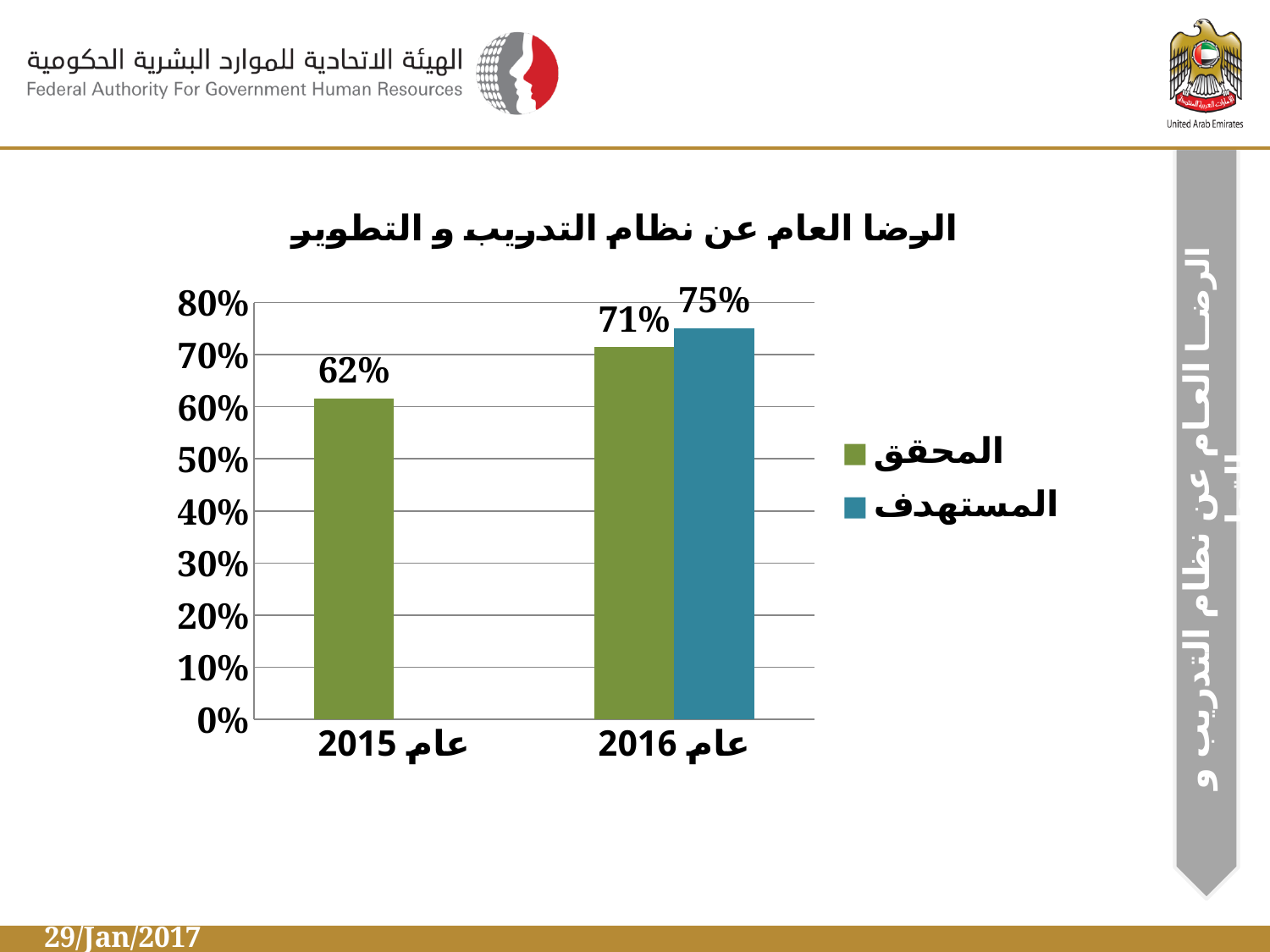
Which category has the highest المحقق value? عام 2016 Is the المحقق value for عام 2015 greater or less than 70%? less Does the المحقق value rise or fall from عام 2015 to عام 2016? rise For عام 2016, which is larger, المحقق or المستهدف? المستهدف What is the difference between المستهدف and المحقق for عام 2016? 4% What kind of chart is shown on the slide? bar chart What is the value of المستهدف for عام 2016? 75% What is the difference between the المحقق values for عام 2016 and عام 2015? 9% What is the value of المحقق for عام 2016? 71% What is the value of المحقق for عام 2015? 62% Which category has the lowest المحقق value? عام 2015 How many series does the legend list? 2